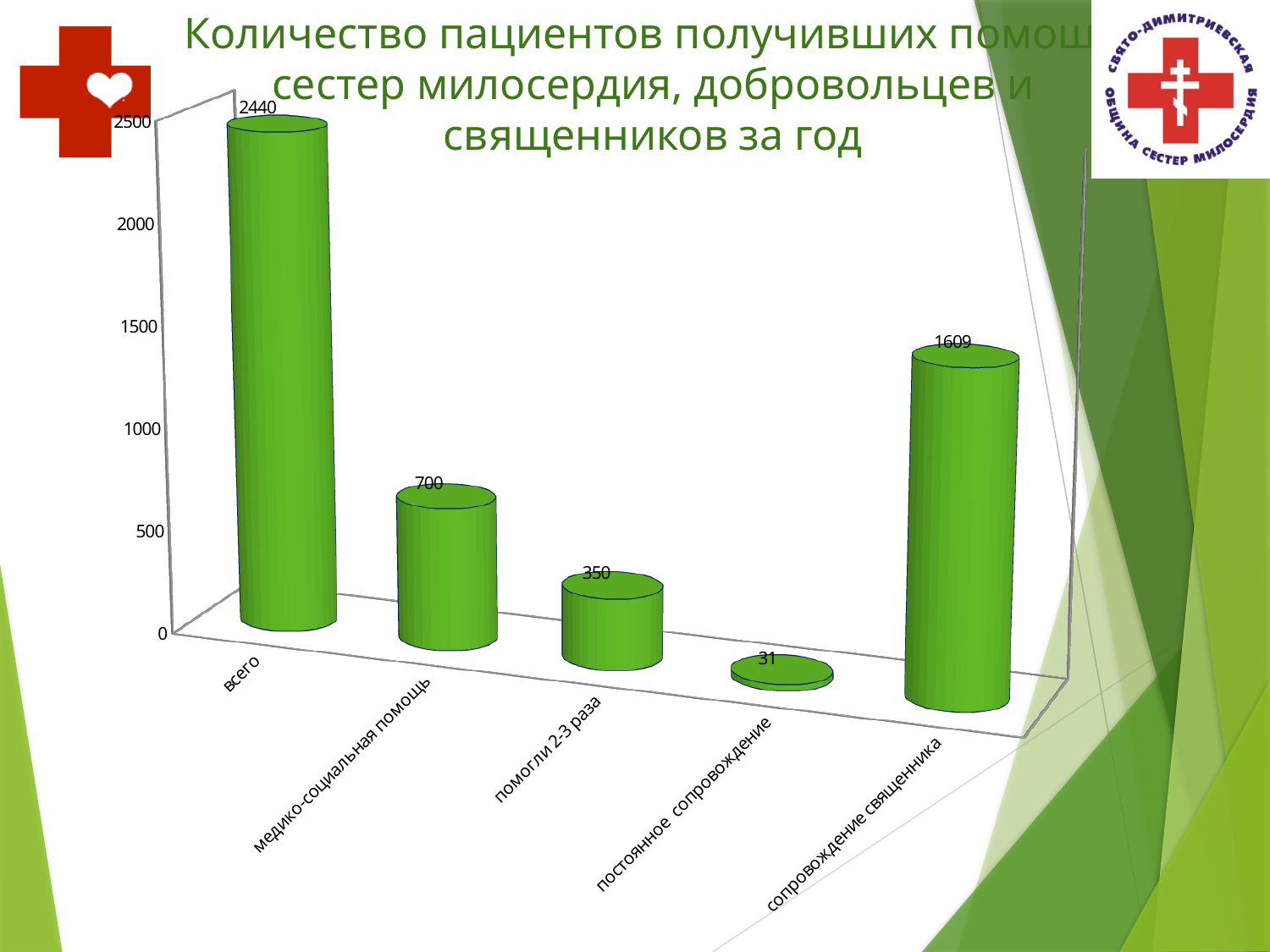
What is the value for "всего"? 2440 What is the value for "сопровождение священника"? 1609 Which category has the highest value? всего Which is larger, the value for "медико-социальная помощь" or the value for "помогли 2-3 раза"? медико-социальная помощь What is the difference between the values for "всего" and "сопровождение священника"? 831 What is the value for "медико-социальная помощь"? 700 What kind of chart is shown on the slide? bar chart Which category has the lowest value? постоянное сопровождение How many categories are shown on the chart? 5 What is the value for "помогли 2-3 раза"? 350 What is the difference between the values for "медико-социальная помощь" and "помогли 2-3 раза"? 350 What is the value for "постоянное сопровождение"? 31